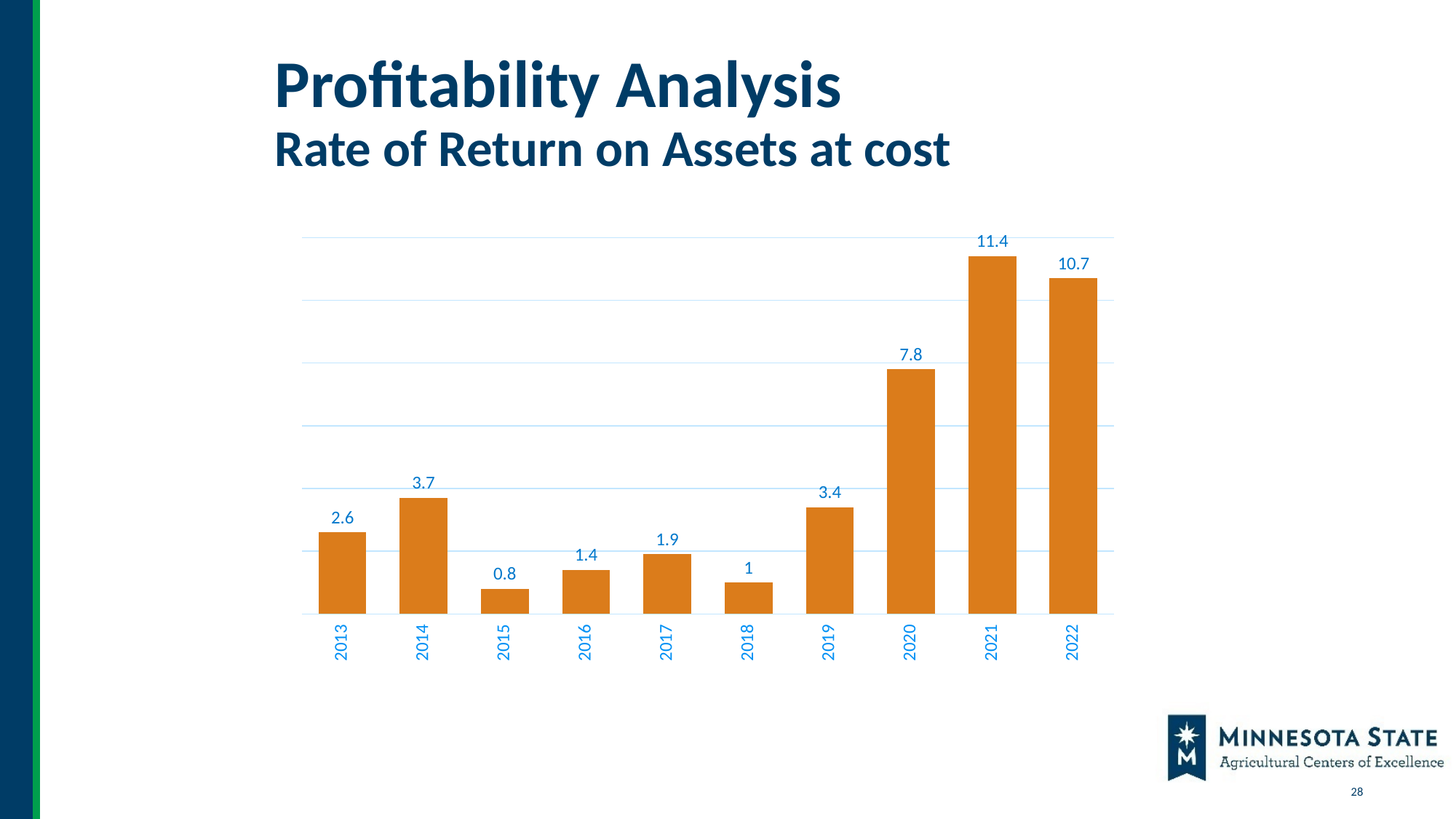
What is the rate of return on assets at cost for 2021? 11.4 What is the value for 2018? 1 What colour are the bars in the chart? Orange What value is shown for 2015? 0.8 What type of chart is shown on the slide? Bar chart Do the values rise or fall from 2018 to 2021? Rise Which year has the lowest rate of return on assets at cost? 2015 What is the difference between the values for 2020 and 2019? 4.4 What is the difference between the values for 2021 and 2022? 0.7 How many years are shown on the chart? 10 Which year has a higher value, 2014 or 2019? 2014 Which year has the highest rate of return on assets at cost? 2021